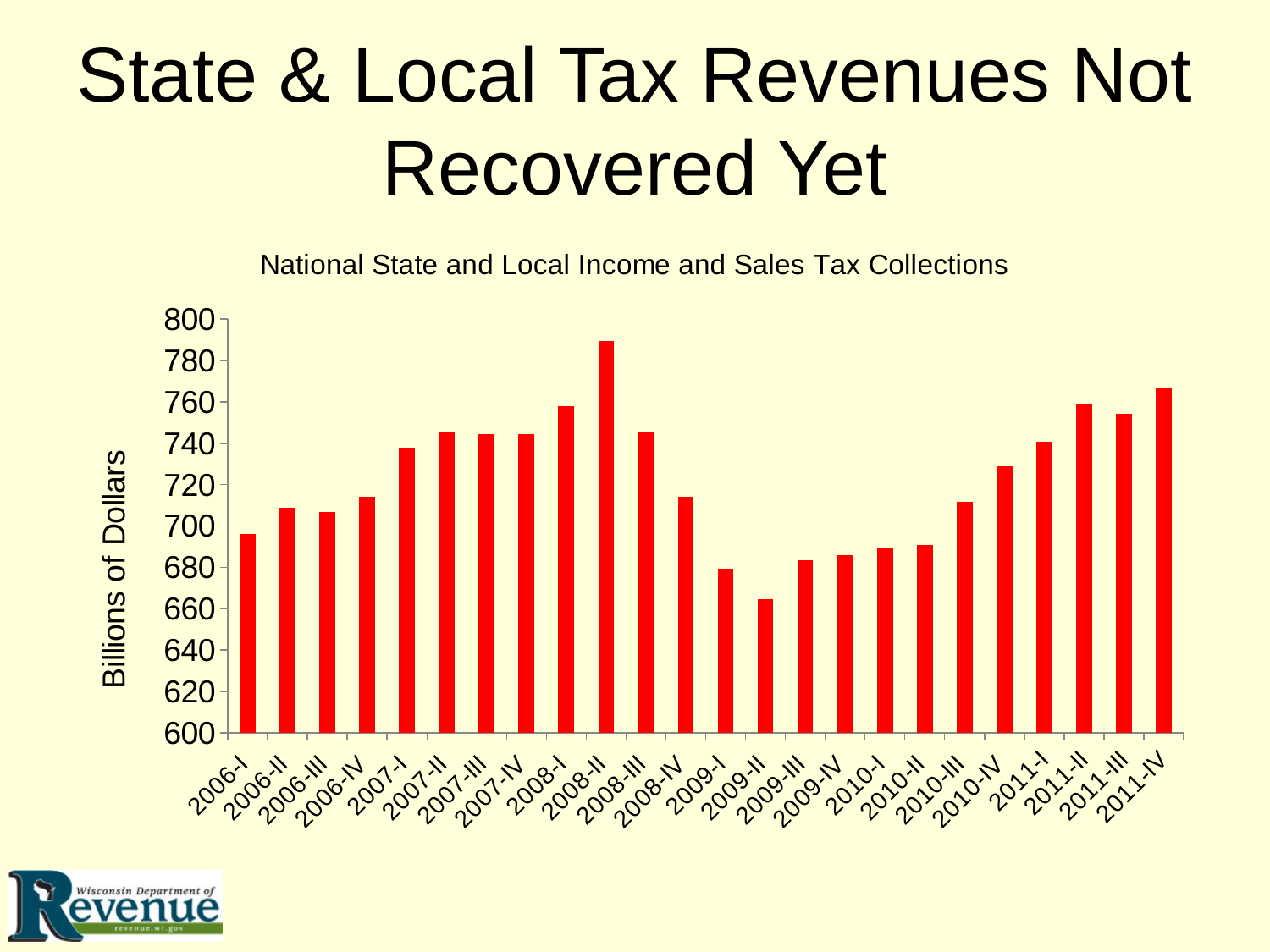
Is the value for 2009-II greater or less than 680? less What is the title of the chart? National State and Local Income and Sales Tax Collections How many quarters (bars) are plotted in the chart? 24 Which quarter has the highest tax collections in the chart? 2008-II What is the label on the vertical axis of the chart? Billions of Dollars Is the value for 2006-I greater or less than 700? less What kind of chart is shown on the slide? bar chart Is the value for 2011-IV greater or less than 760? greater Which quarter has the lowest tax collections in the chart? 2009-II Do the values rise or fall from 2009-II to 2011-IV? rise Which is larger, the value for 2008-II or the value for 2011-IV? 2008-II